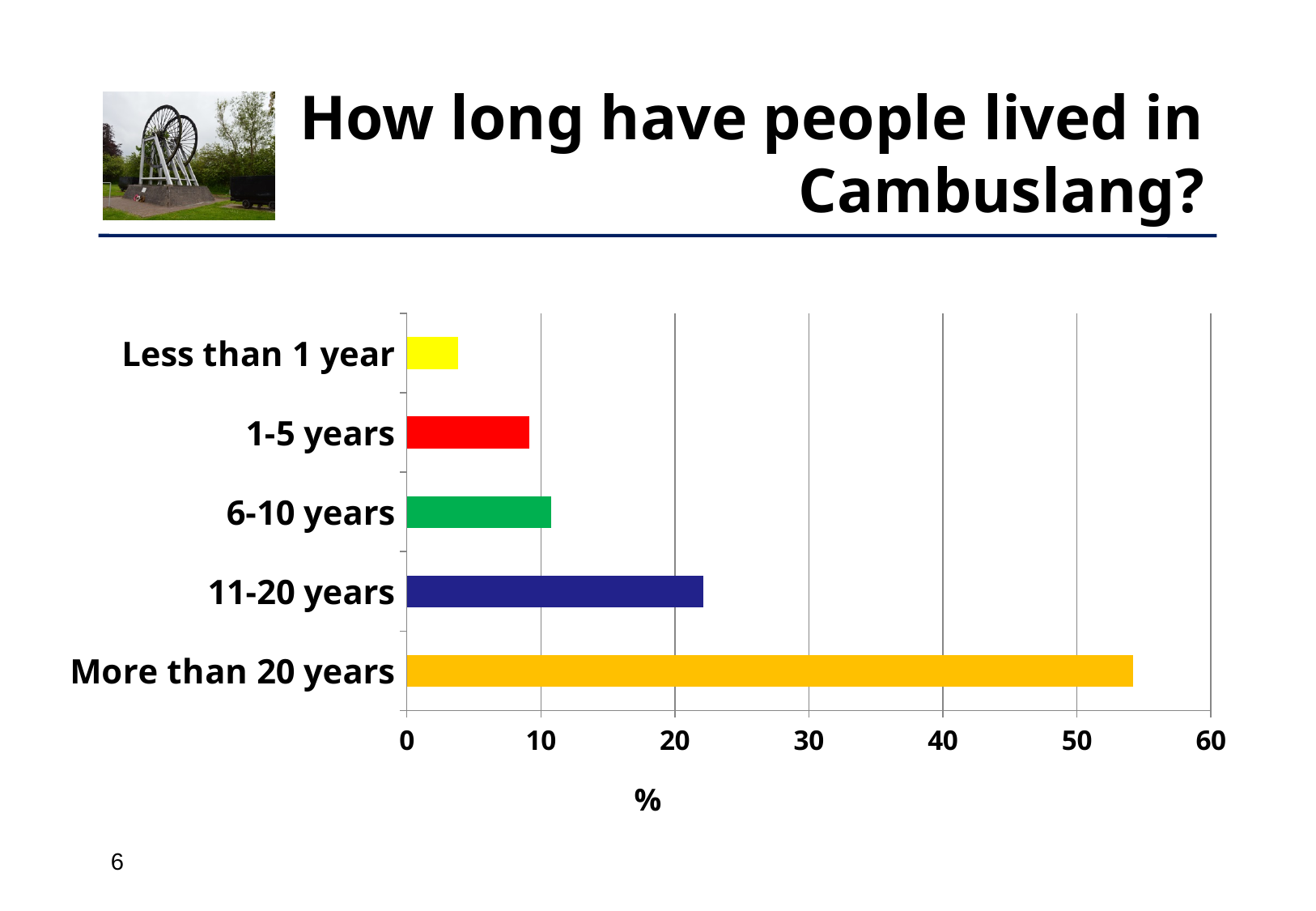
Which is larger, the value for 11-20 years or the value for 6-10 years? 11-20 years What kind of chart is shown on the slide? bar chart What colour is the bar for More than 20 years? orange Which is larger, the value for 1-5 years or the value for Less than 1 year? 1-5 years Is the value for 11-20 years greater or less than 10? greater Is the value for Less than 1 year greater or less than 10? less Which category has the highest value? More than 20 years What is the label on the horizontal axis of the chart? % How many categories are plotted in the chart? 5 Is the value for 11-20 years greater or less than 30? less Which category has the lowest value? Less than 1 year